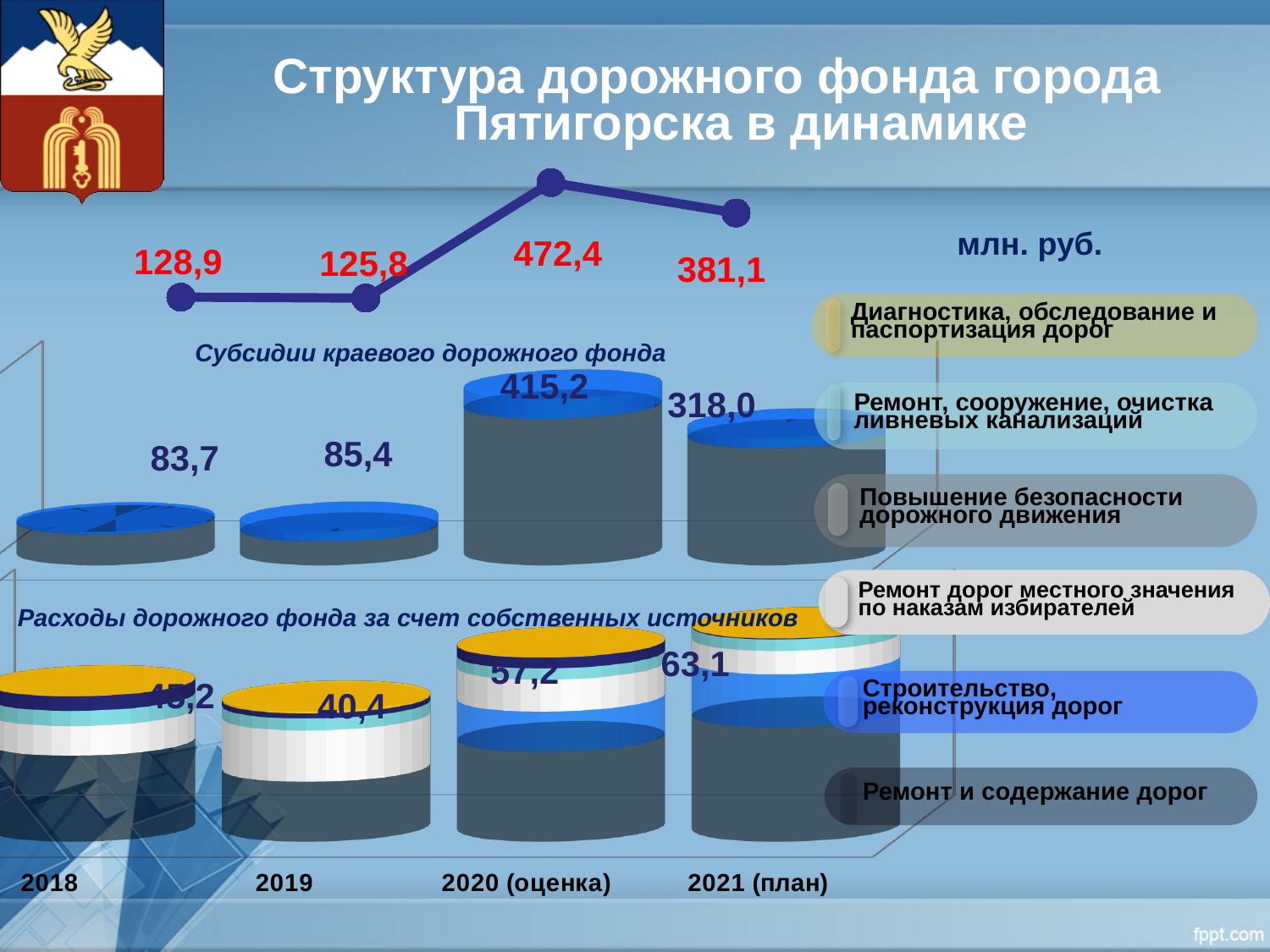
In the chart 'Субсидии краевого дорожного фонда', what is the value for 2019? 85,4 On the line chart at the top, what is the value for 2018? 128,9 On the line chart at the top, which year has the lowest value? 2019 In the chart 'Субсидии краевого дорожного фонда', which is larger: the value for 2018 or the value for 2019? 2019 On the line chart at the top, what is the difference between the 2020 (оценка) value and the 2021 (план) value? 91,3 In the chart 'Субсидии краевого дорожного фонда', what is the value for 2021 (план)? 318,0 On the line chart at the top, what is the value for 2020 (оценка)? 472,4 On the line chart at the top, which year has the highest value? 2020 (оценка) In the chart 'Субсидии краевого дорожного фонда', which year has the highest value? 2020 (оценка) In the chart 'Расходы дорожного фонда за счет собственных источников', what is the value for 2021 (план)? 63,1 How many years are shown along the x axis of the charts? 4 In the chart 'Расходы дорожного фонда за счет собственных источников', what is the difference between the 2021 (план) value and the 2019 value? 22,7